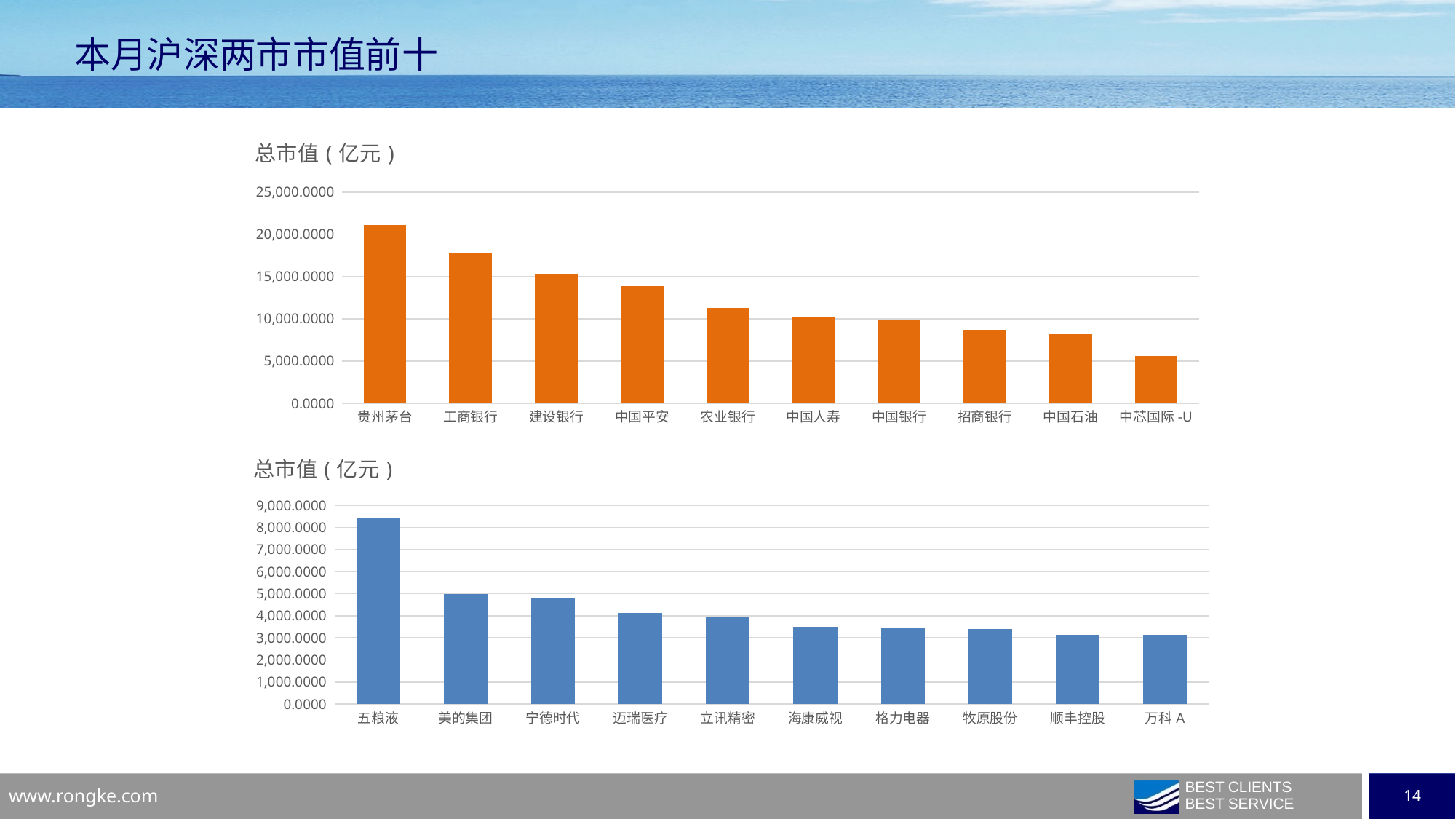
In the bottom chart, which company has the highest total market value? 五粮液 In the top chart, which is larger, the value for 工商银行 or the value for 建设银行? 工商银行 How many companies are shown in the top chart? 10 In the top chart, is the value for 农业银行 greater or less than 10,000? greater In the top chart, which company has the lowest total market value? 中芯国际 -U In the top chart, is the value for 贵州茅台 greater or less than 20,000? greater In the top chart, which company has the highest total market value? 贵州茅台 In the top chart, is the value for 中国平安 greater or less than 15,000? less In the bottom chart, which is larger, the value for 美的集团 or the value for 迈瑞医疗? 美的集团 What kind of chart is the bottom chart? bar chart